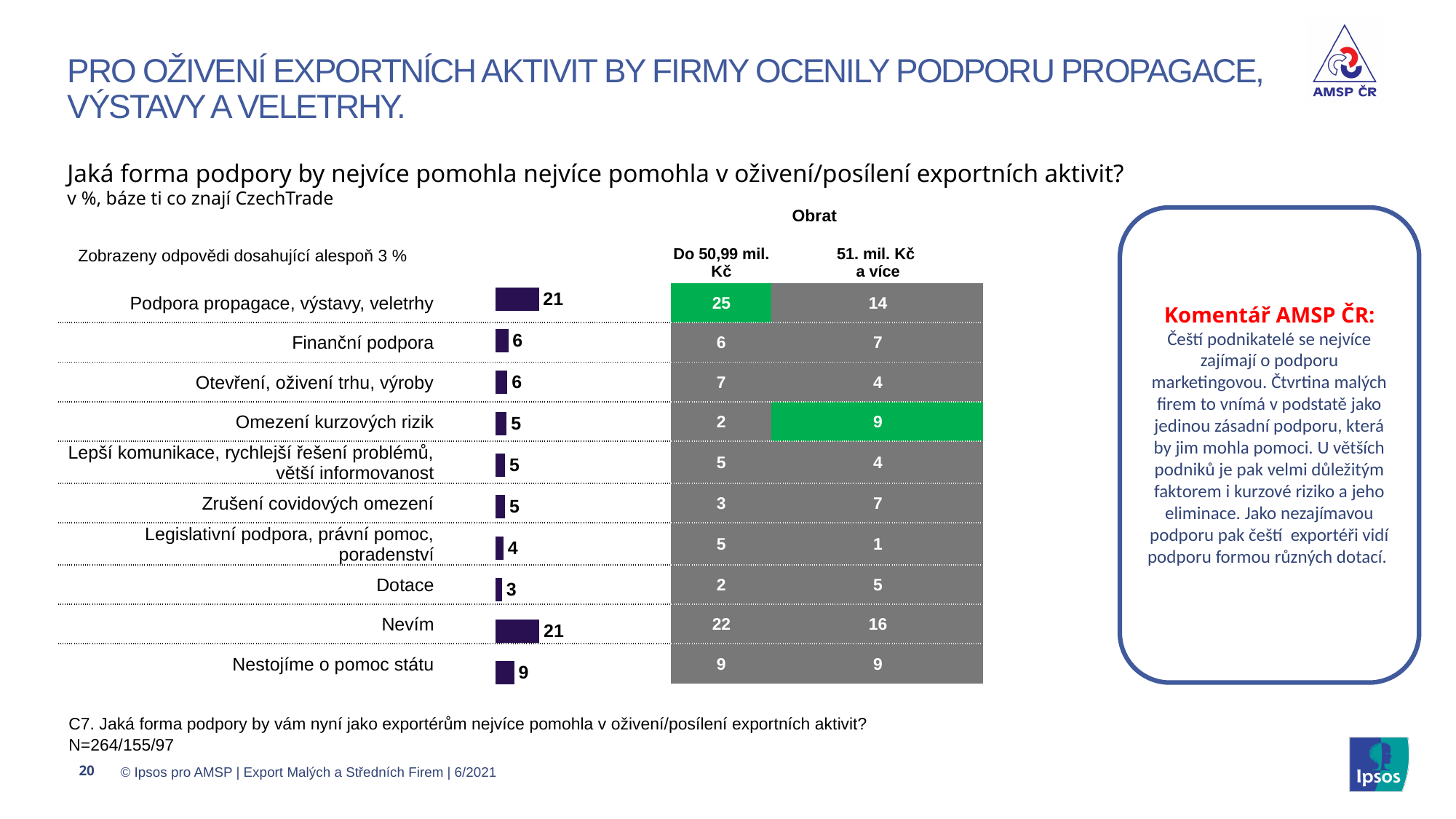
What is the value for "Nestojíme o pomoc státu" in the bar chart? 9 In the table next to the chart, what is the value for "Podpora propagace, výstavy, veletrhy" in the "Do 50,99 mil. Kč" column? 25 What is the difference between the values for "Nevím" and "Nestojíme o pomoc státu" in the bar chart? 12 What minimum response share is required for an answer to be displayed in the chart, according to the note above it? 3 % Which is larger in the bar chart: "Finanční podpora" or "Legislativní podpora, právní pomoc, poradenství"? Finanční podpora Which category has the lowest value in the bar chart? Dotace In the table next to the chart, what is the value for "Omezení kurzových rizik" in the "51. mil. Kč a více" column? 9 How many categories does the bar chart show? 10 What is the value for "Podpora propagace, výstavy, veletrhy" in the bar chart? 21 What is the difference between the values for "Podpora propagace, výstavy, veletrhy" and "Finanční podpora" in the bar chart? 15 What is the value for "Dotace" in the bar chart? 3 What type of chart is shown on the slide? bar chart